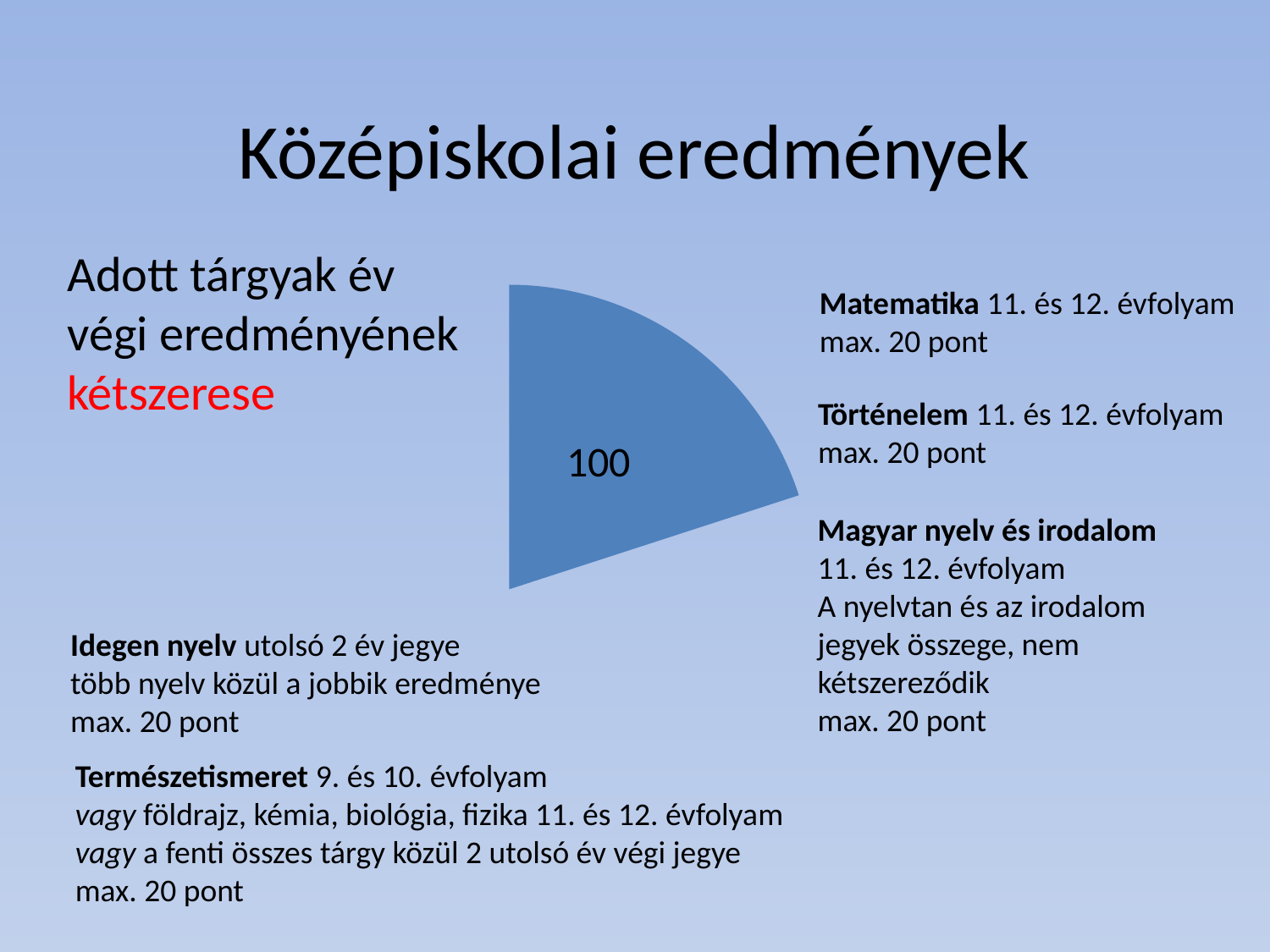
What kind of chart is shown on the slide? pie chart How many data labels are printed on the pie chart? 1 What value is printed on the visible slice of the pie chart? 100 What colour is the visible slice of the pie chart? blue Does the pie chart have a legend? no How many slices are visible in the pie chart? 1